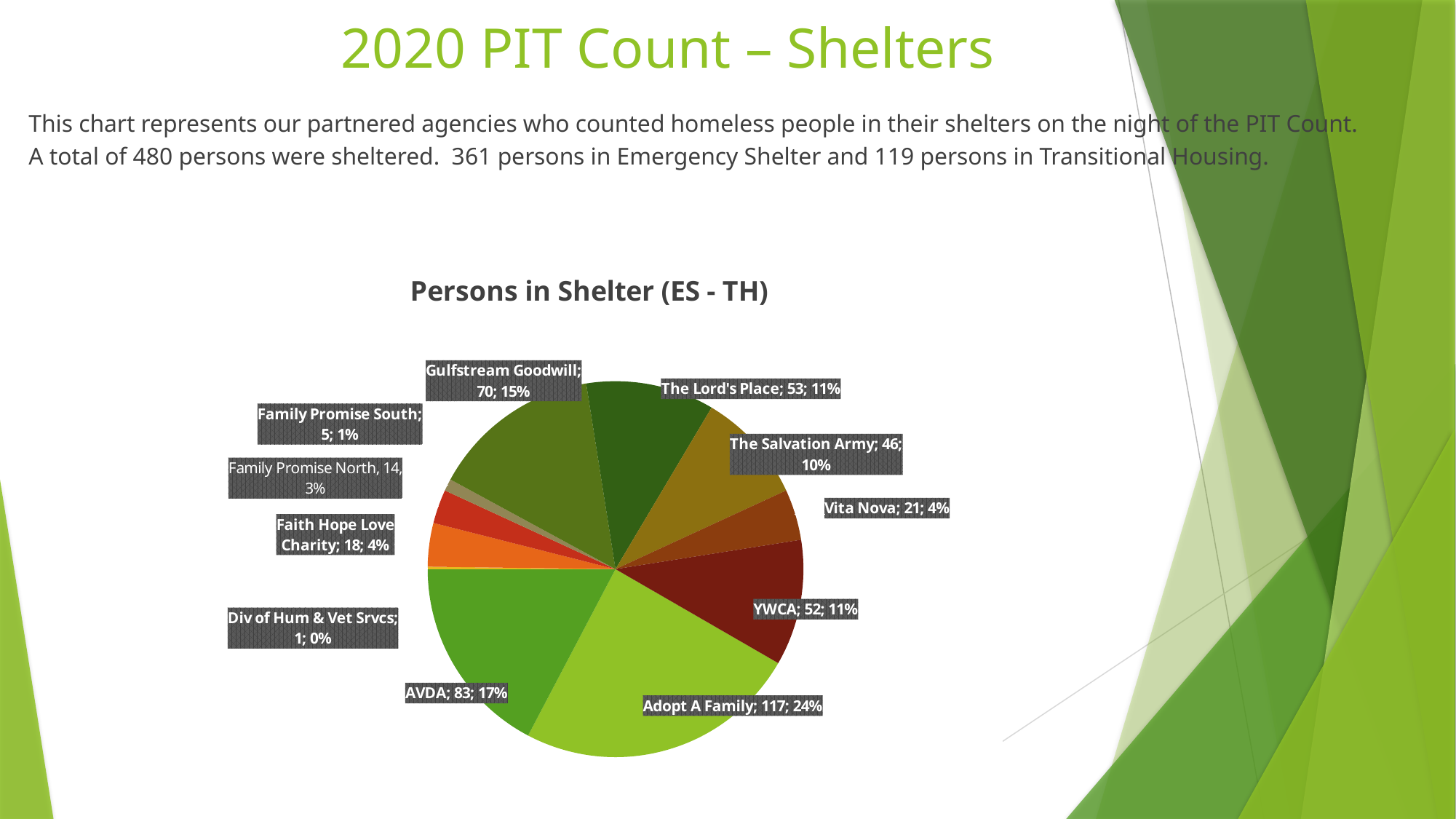
Which has more persons, The Lord's Place or The Salvation Army? The Lord's Place What percentage share of the pie does The Salvation Army have? 10% What is the difference in persons between Adopt A Family and AVDA? 34 How many persons are shown for Family Promise North? 14 How many persons are shown for Gulfstream Goodwill? 70 Which agency has the smallest slice of the pie? Div of Hum & Vet Srvcs What kind of chart is shown on the slide? Pie chart Which agency has the largest slice of the pie? Adopt A Family What is the title of the chart? Persons in Shelter (ES - TH) What percentage share of the pie does AVDA have? 17% How many agencies (slices) are shown in the pie chart? 11 How many persons are shown for Adopt A Family? 117